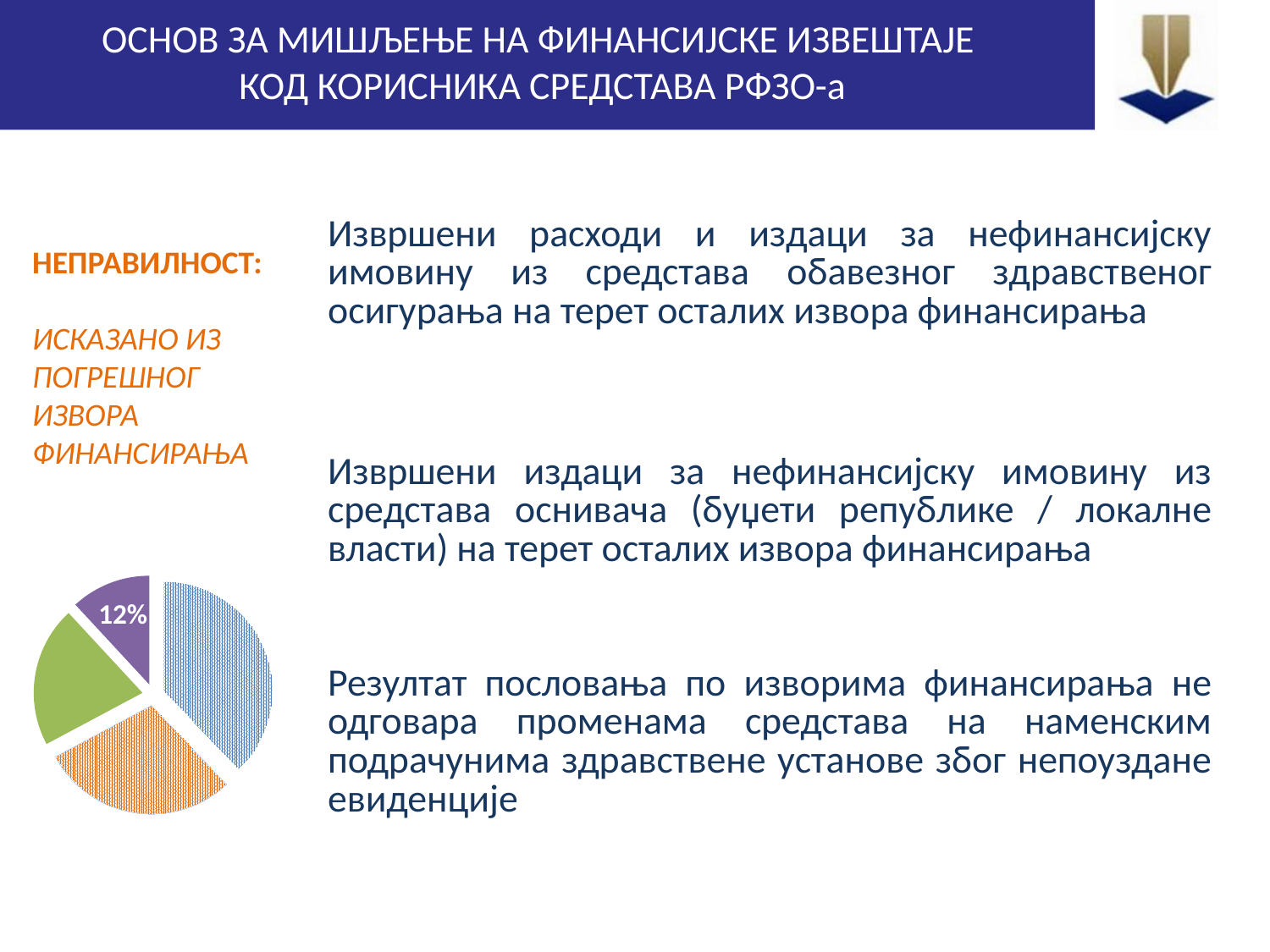
Which is larger in the pie chart, the blue slice or the purple slice? the blue slice What kind of chart is shown on the slide? pie chart Which is larger in the pie chart, the orange slice or the purple slice? the orange slice What value is printed on the purple slice of the pie chart? 12% Which slice of the pie chart is the largest? the blue slice Which slice of the pie chart carries the only printed data label? the purple slice How many slices does the pie chart have? 4 Which slice of the pie chart is the smallest? the purple slice How many slices of the pie chart have a data label printed on them? 1